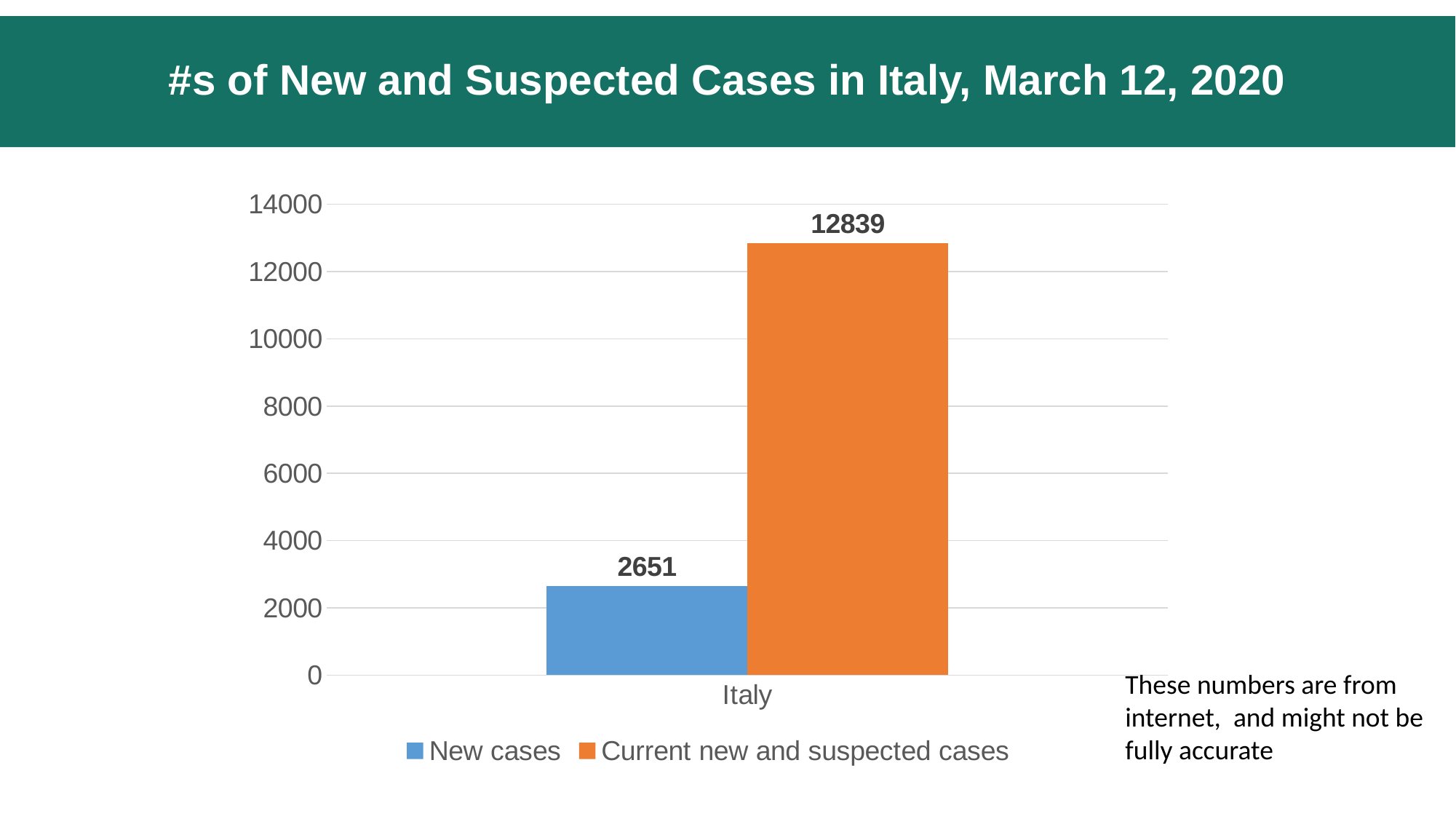
Is the value for New cases larger or smaller than the value for Current new and suspected cases? smaller How many series does the legend list? 2 What kind of chart is shown on the slide? bar chart Is the value for Current new and suspected cases greater or less than 12000? greater Which series has the higher value for Italy? Current new and suspected cases What is the value for Current new and suspected cases in Italy? 12839 What is the difference between Current new and suspected cases and New cases for Italy? 10188 What is the title of the chart? #s of New and Suspected Cases in Italy, March 12, 2020 What is the value for New cases in Italy? 2651 Which series has the lower value for Italy? New cases How many categories are shown on the x axis? 1 Is the value for New cases greater or less than 4000? less